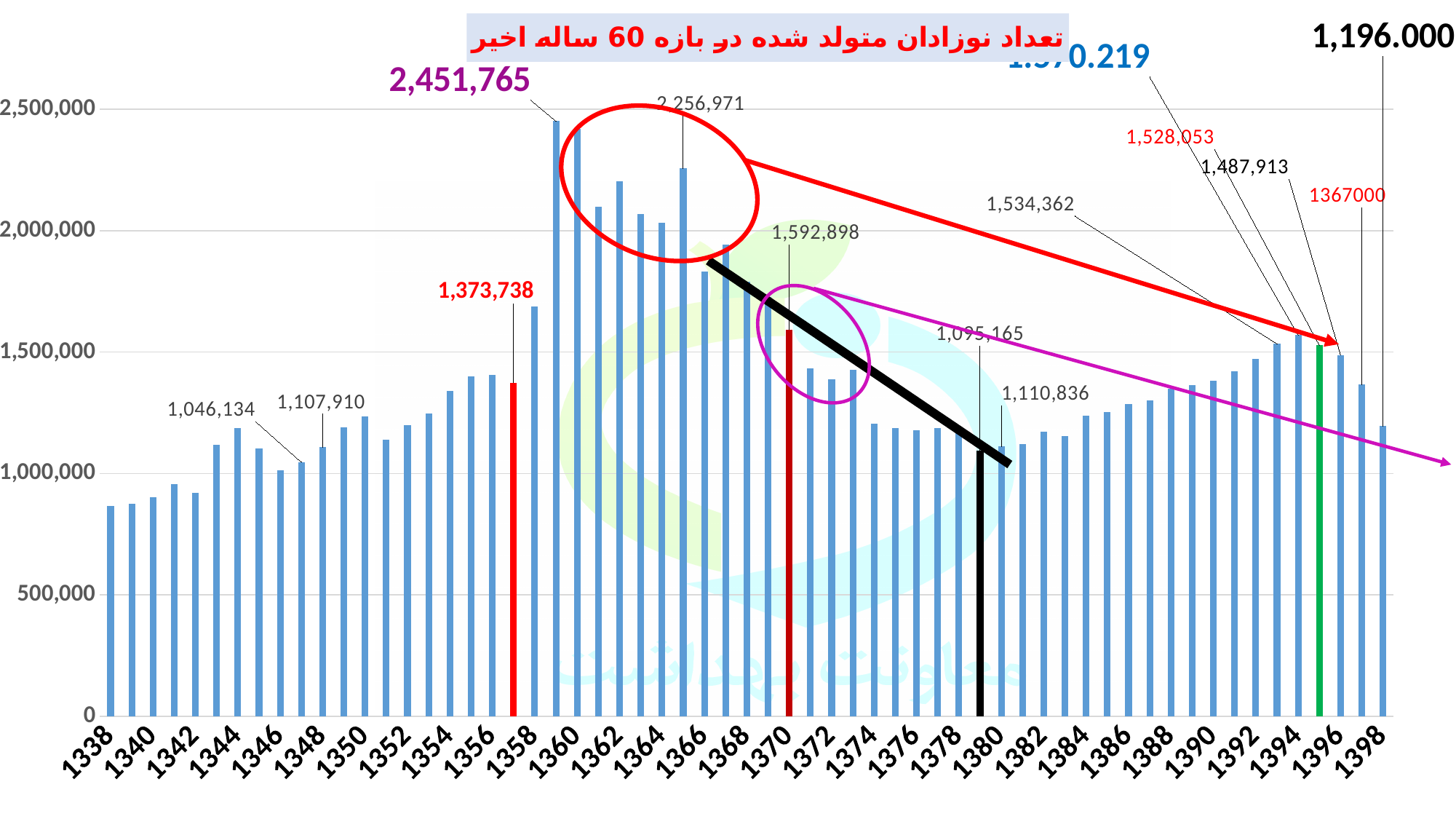
Which is larger, the value for 1370 or the value for 1379? 1370 Do the values rise or fall from 1359 to 1379? fall What is the value labelled for the last bar, year 1398? 1,196.000 What is the value of the tallest bar (year 1359)? 2,451,765 Is the value for 1338 greater or less than 1,000,000? less What kind of chart is shown on the slide? bar chart What colour is the bar at year 1395? green What is the value of the black bar at year 1379? 1,095,165 What is the value of the red bar at year 1370? 1,592,898 What is the value of the red bar at year 1357? 1,373,738 What is the difference between the value for 1359 (2,451,765) and the value for 1357 (1,373,738)? 1,078,027 Which year has the highest number of births? 1359